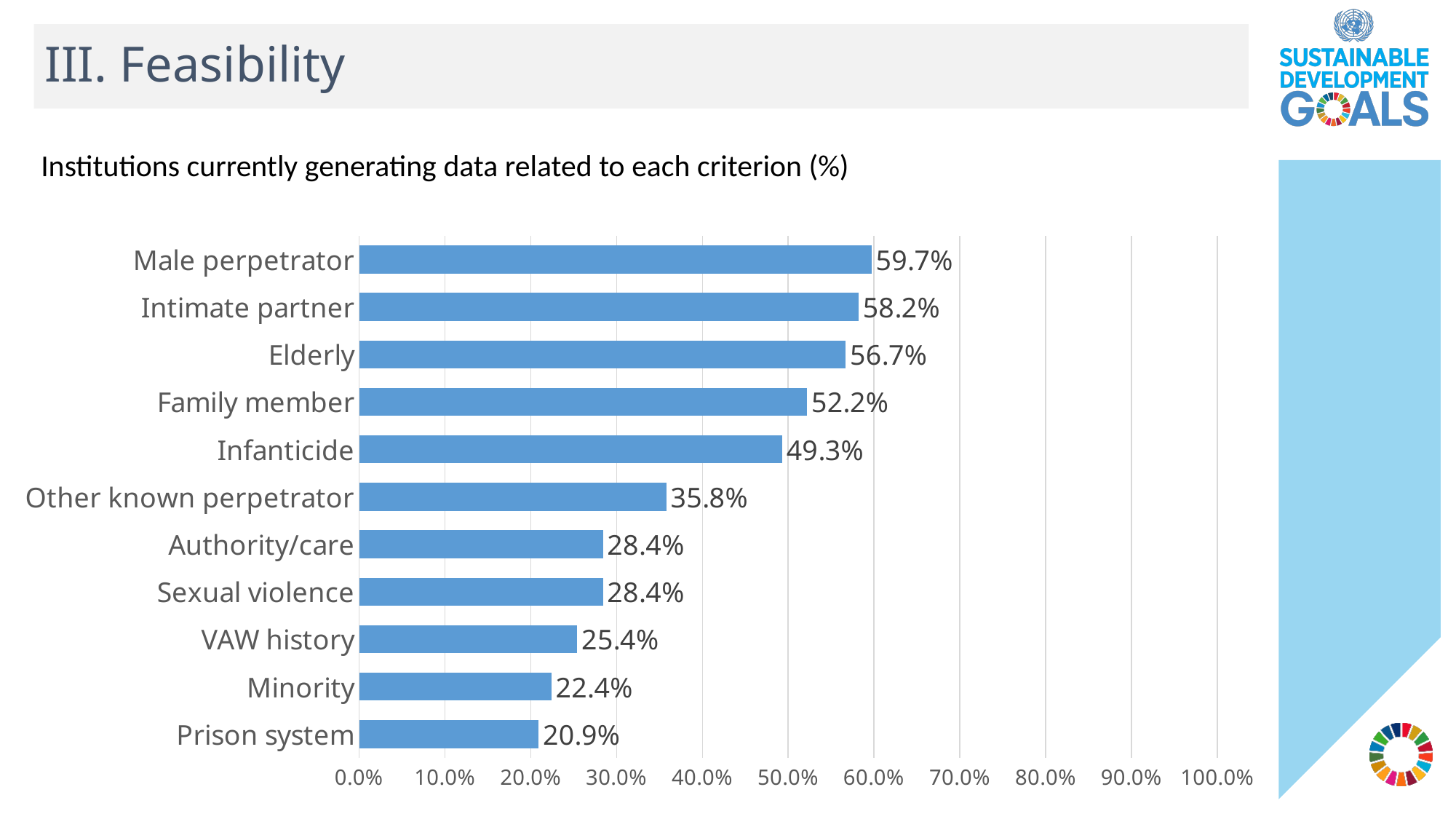
Which has a larger value, Elderly or Infanticide? Elderly What is the title of the chart? Institutions currently generating data related to each criterion (%) What is the value shown for Infanticide? 49.3% What is the value shown for Prison system? 20.9% How many criteria are shown in the chart? 11 What is the difference between the values for Family member and Other known perpetrator? 16.4% Which criterion has the highest percentage of institutions generating data? Male perpetrator What is the difference between the values for Male perpetrator and Prison system? 38.8% Is the value for Intimate partner greater or less than 50.0%? greater What percentage of institutions currently generate data related to the Male perpetrator criterion? 59.7% Which criterion has the lowest percentage of institutions generating data? Prison system What kind of chart is shown on the slide? Bar chart